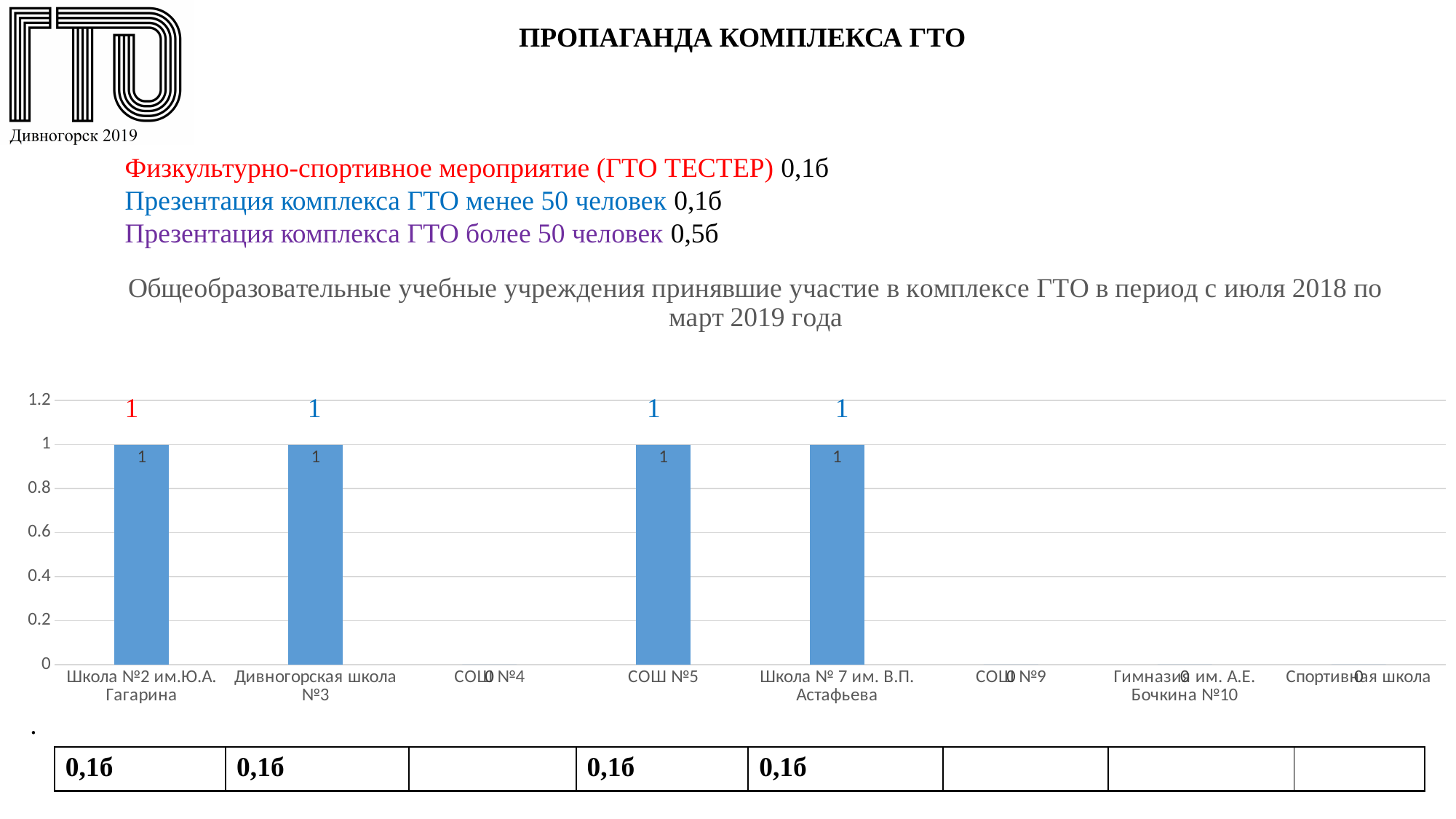
What is the value for СОШ №5? 1 Which is larger, the value for Дивногорская школа №3 or the value for СОШ №9? Дивногорская школа №3 What is the highest value shown on the vertical axis of the chart? 1.2 What type of chart is shown on the slide? bar chart What is the value for Спортивная школа? 0 How many categories (schools) are shown on the x axis of the chart? 8 What is the value for СОШ №4? 0 What is the value for Школа №2 им.Ю.А. Гагарина? 1 What is the difference between the value for Школа № 7 им. В.П. Астафьева and the value for СОШ №4? 1 What period does the chart title say the data covers? с июля 2018 по март 2019 года How many schools have a value of 1 in the chart? 4 What is the value for Гимназия им. А.Е. Бочкина №10? 0